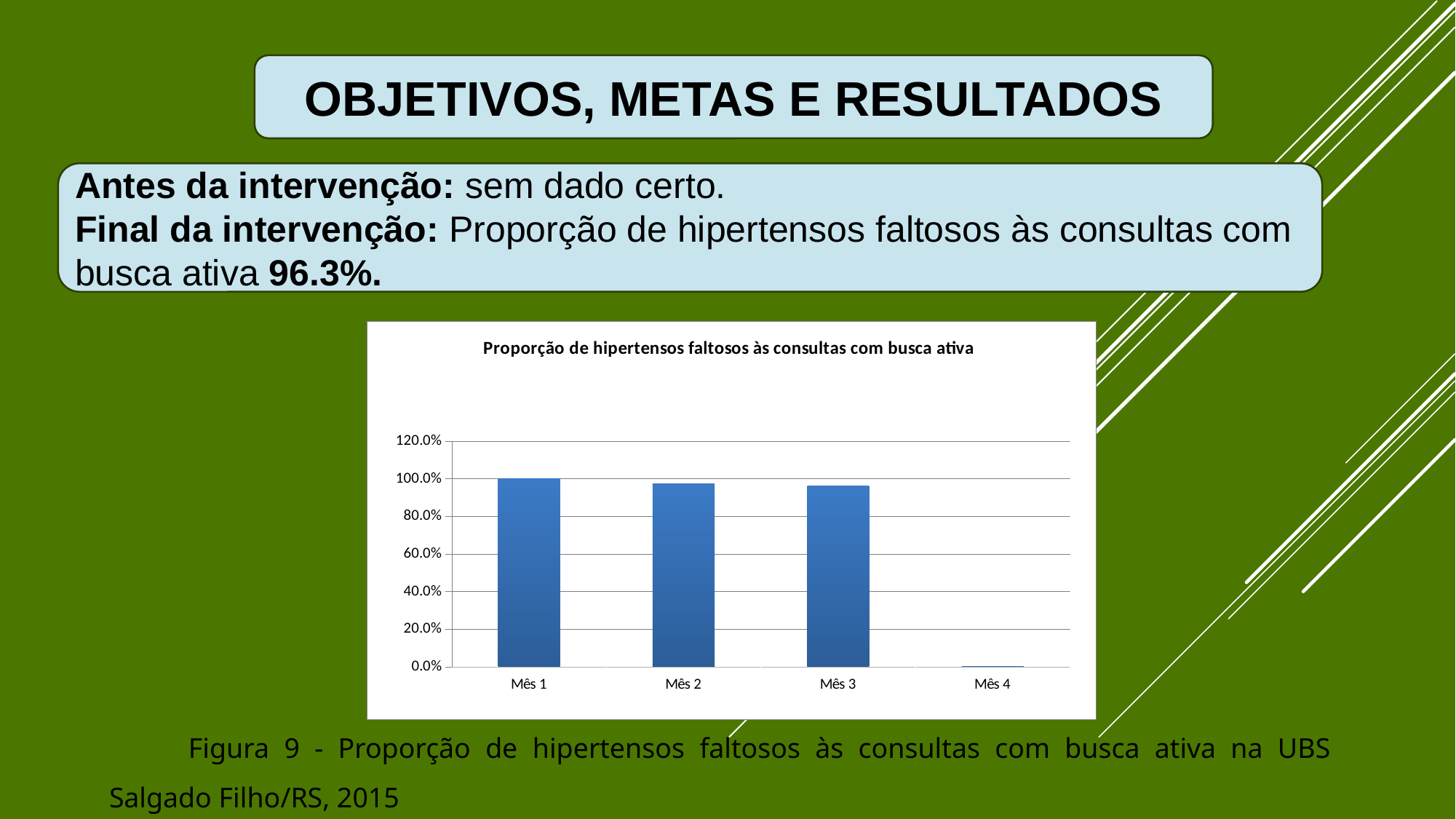
Is the value for Mês 4 greater or less than 20.0%? less Is the value for Mês 2 greater or less than 80.0%? greater What is the highest value shown on the y axis of the chart? 120.0% Do the values rise or fall from Mês 1 to Mês 4? fall Which month has the highest value in the chart? Mês 1 What is the value for Mês 1? 100.0% Is the value for Mês 3 greater or less than 80.0%? greater How many categories (months) are shown on the x axis of the chart? 4 What is the title of the chart? Proporção de hipertensos faltosos às consultas com busca ativa Which is larger, the value for Mês 1 or the value for Mês 4? Mês 1 Which month has the lowest value in the chart? Mês 4 What kind of chart is shown on the slide? bar chart